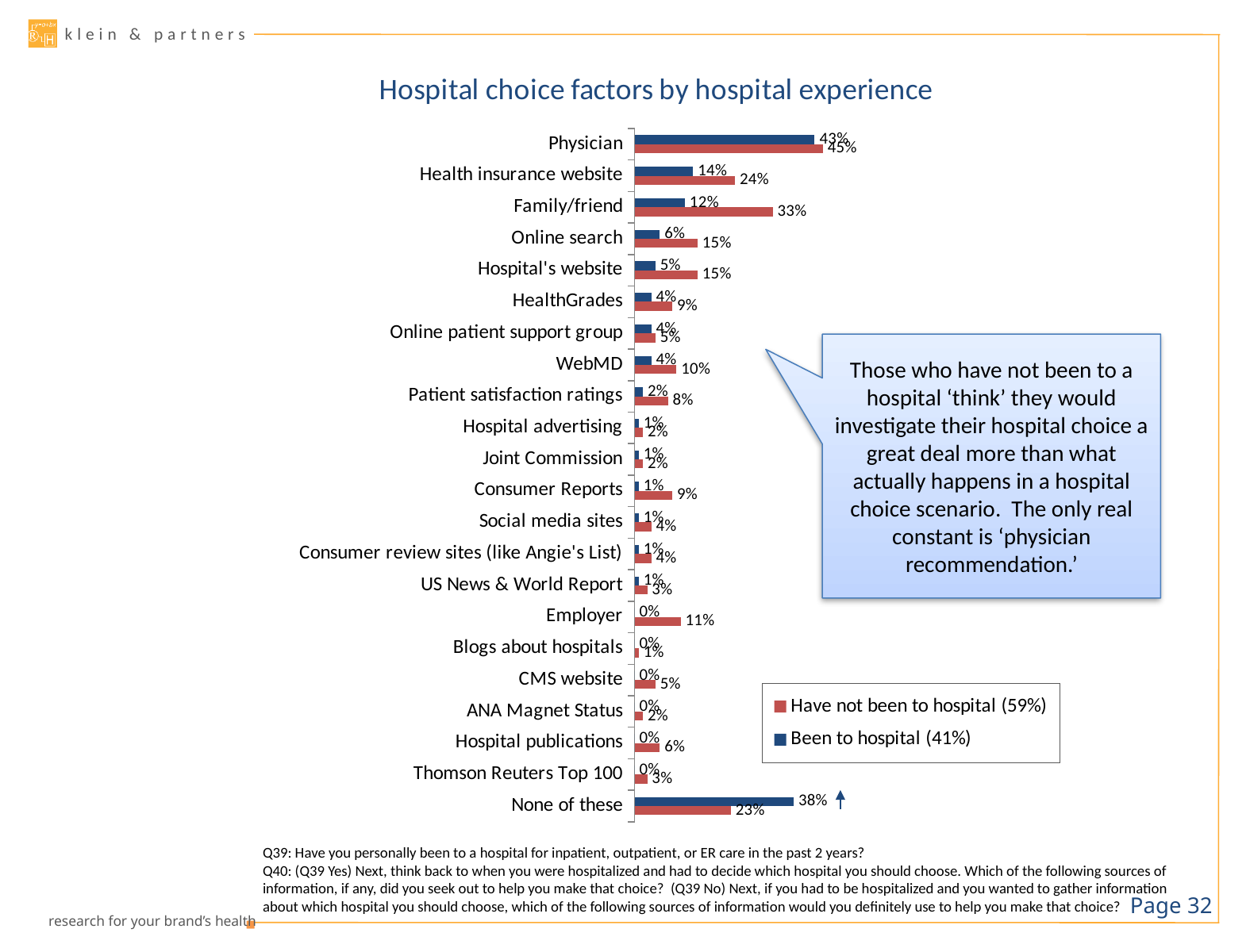
How many series does the legend list? 2 For Consumer Reports, which series has the larger value? Have not been to hospital (59%) What is the difference between the two series' values for Family/friend? 21% What is the difference between the 'Have not been to hospital (59%)' and 'Been to hospital (41%)' values for Health insurance website? 10% For 'None of these', which series has the larger value: 'Been to hospital (41%)' or 'Have not been to hospital (59%)'? Been to hospital (41%) How many categories are shown on the chart? 22 What is the value for 'None of these' in the 'Been to hospital (41%)' series? 38% What percentage of the 'Been to hospital (41%)' group chose Physician? 43% What is the value for Employer in the 'Have not been to hospital (59%)' series? 11% What type of chart is shown on the slide? Bar chart What percentage of the 'Have not been to hospital (59%)' group chose Family/friend? 33% Which category has the highest value in the 'Have not been to hospital (59%)' series? Physician